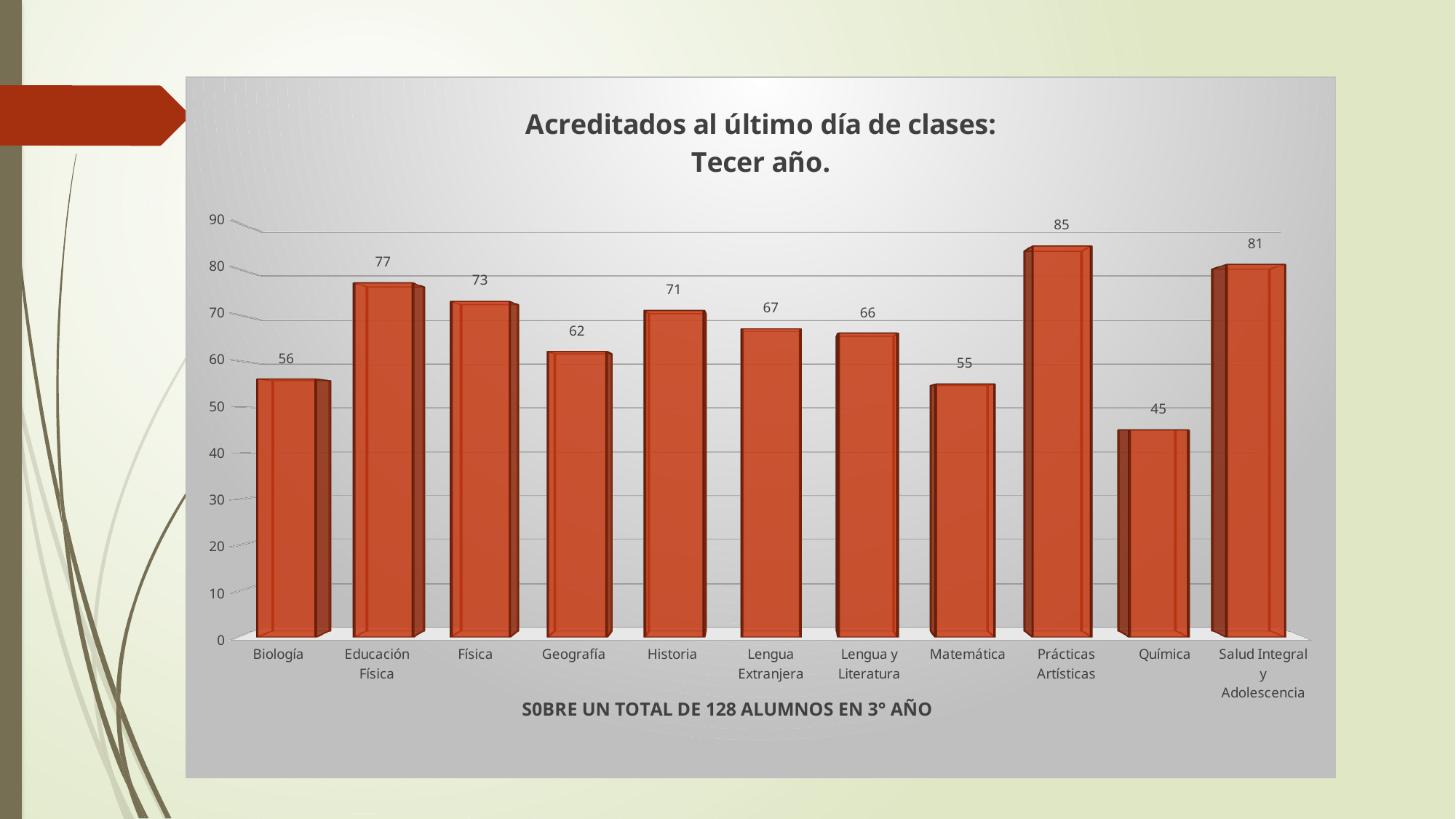
What is the value for Biología? 56 Which subject has the lowest value? Química Which is larger, the value for Historia or the value for Geografía? Historia How many subjects are shown on the x axis? 11 What kind of chart is shown on the slide? bar chart Which subject has the highest value? Prácticas Artísticas What is the difference between the values for Educación Física and Física? 4 What is the difference between the values for Salud Integral y Adolescencia and Química? 36 What is the value for Prácticas Artísticas? 85 Is the value for Matemática greater or less than 60? less What is the title of the chart? Acreditados al último día de clases: Tecer año. What is the value for Lengua Extranjera? 67